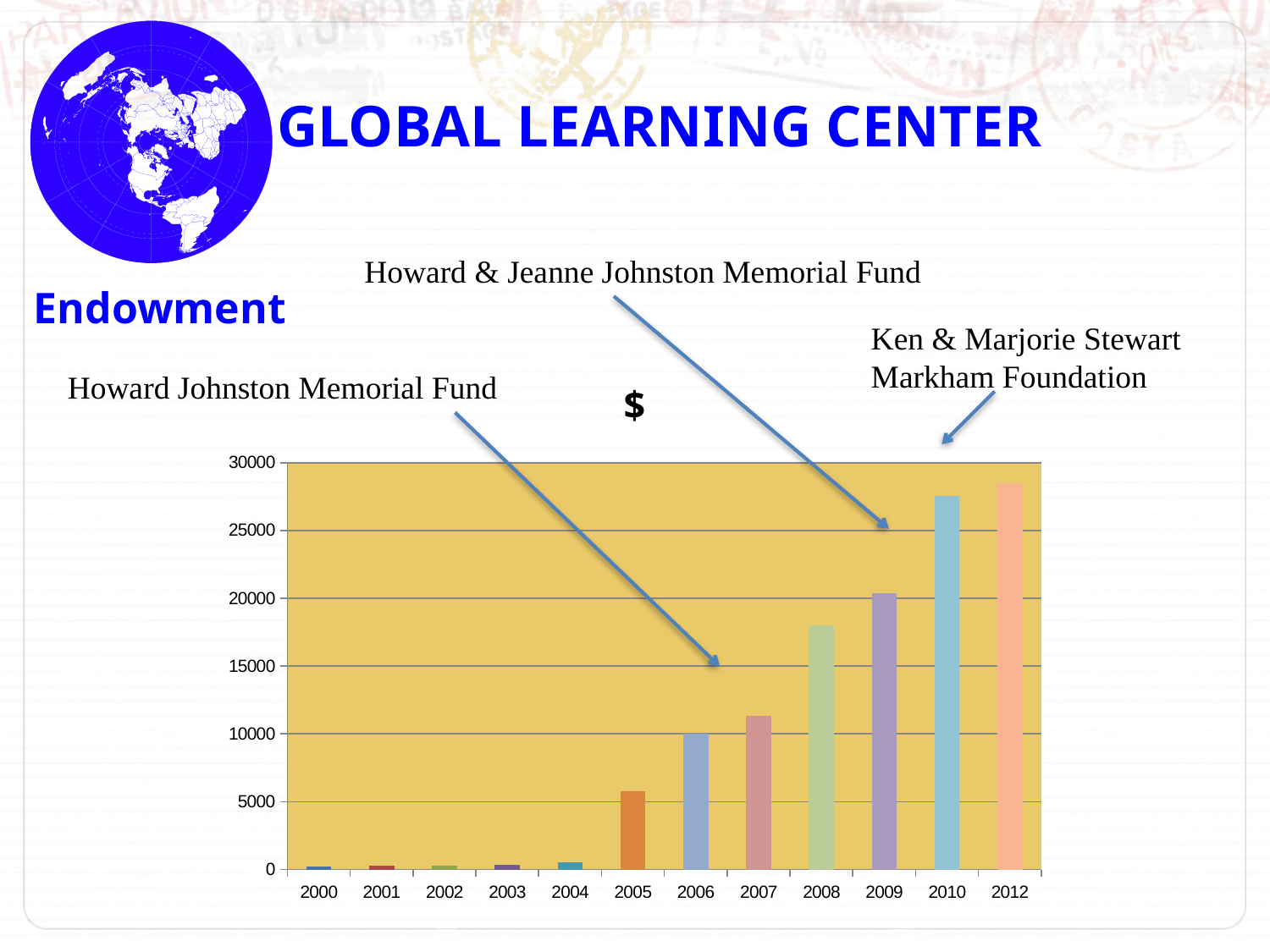
Is the value for 2007 greater or less than 15000? less Is the value for 2004 greater or less than 5000? less What kind of chart is shown on the slide? bar chart Do the values generally rise or fall from 2000 to 2012? rise Which is larger, the value for 2005 or the value for 2007? 2007 Which year has the highest bar in the chart? 2012 How many years are shown on the x axis of the chart? 12 What is the title shown above the chart? $ Which is larger, the value for 2010 or the value for 2008? 2010 Is the value for 2005 greater or less than 5000? greater